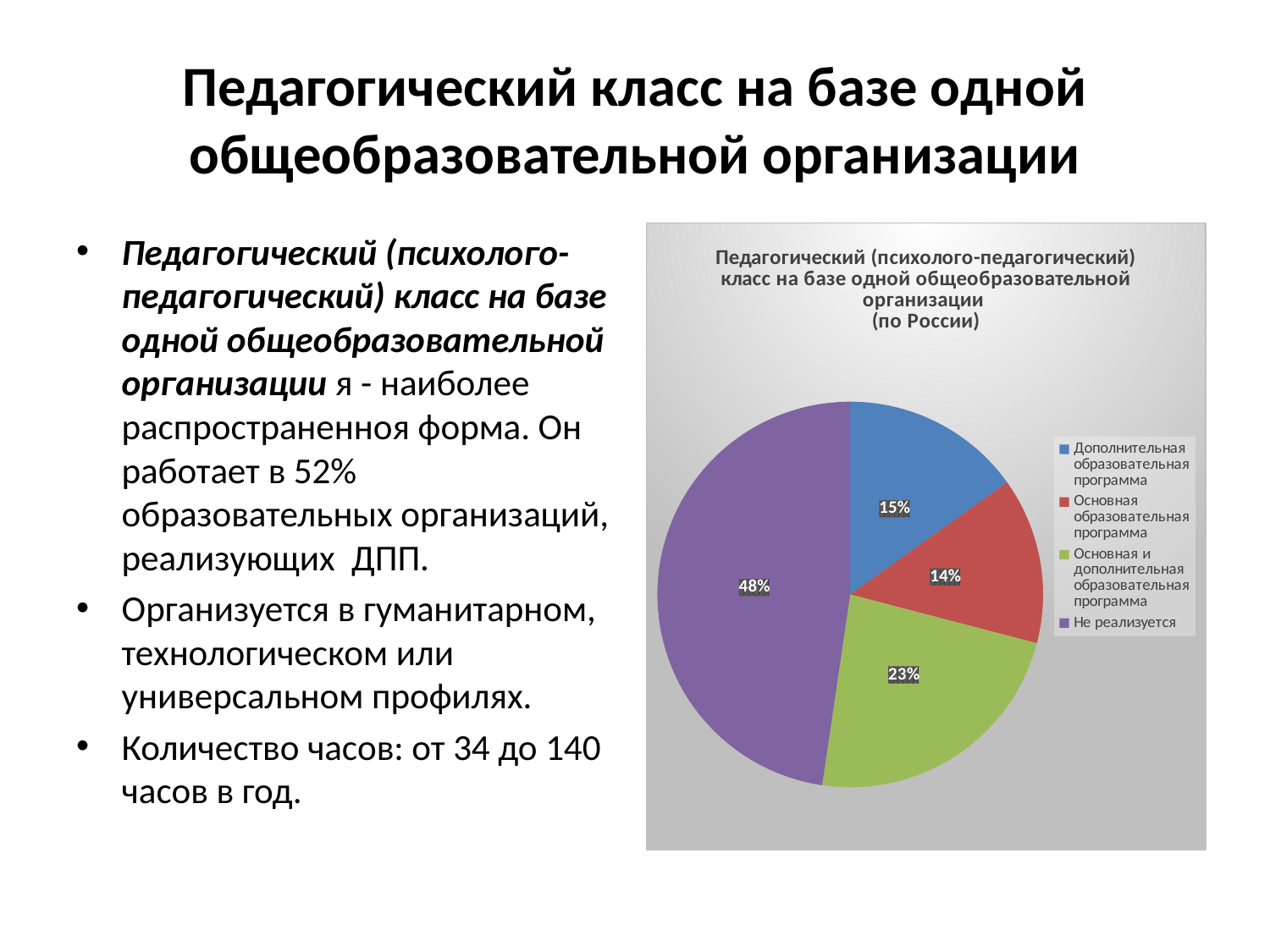
What share of the pie is labelled "Дополнительная образовательная программа"? 15% Which category has the smallest slice of the pie? Основная образовательная программа How many slices does the pie chart have? 4 What share of the pie is labelled "Основная и дополнительная образовательная программа"? 23% Which category has the largest slice of the pie? Не реализуется What kind of chart is shown on the slide? Pie chart What share of the pie is labelled "Не реализуется"? 48% What share of the pie is labelled "Основная образовательная программа"? 14% What colour is the slice for "Не реализуется"? Purple Which is larger: the slice for "Дополнительная образовательная программа" or the slice for "Основная и дополнительная образовательная программа"? Основная и дополнительная образовательная программа How many entries does the legend list? 4 What is the difference in percentage points between "Не реализуется" and "Основная и дополнительная образовательная программа"? 25